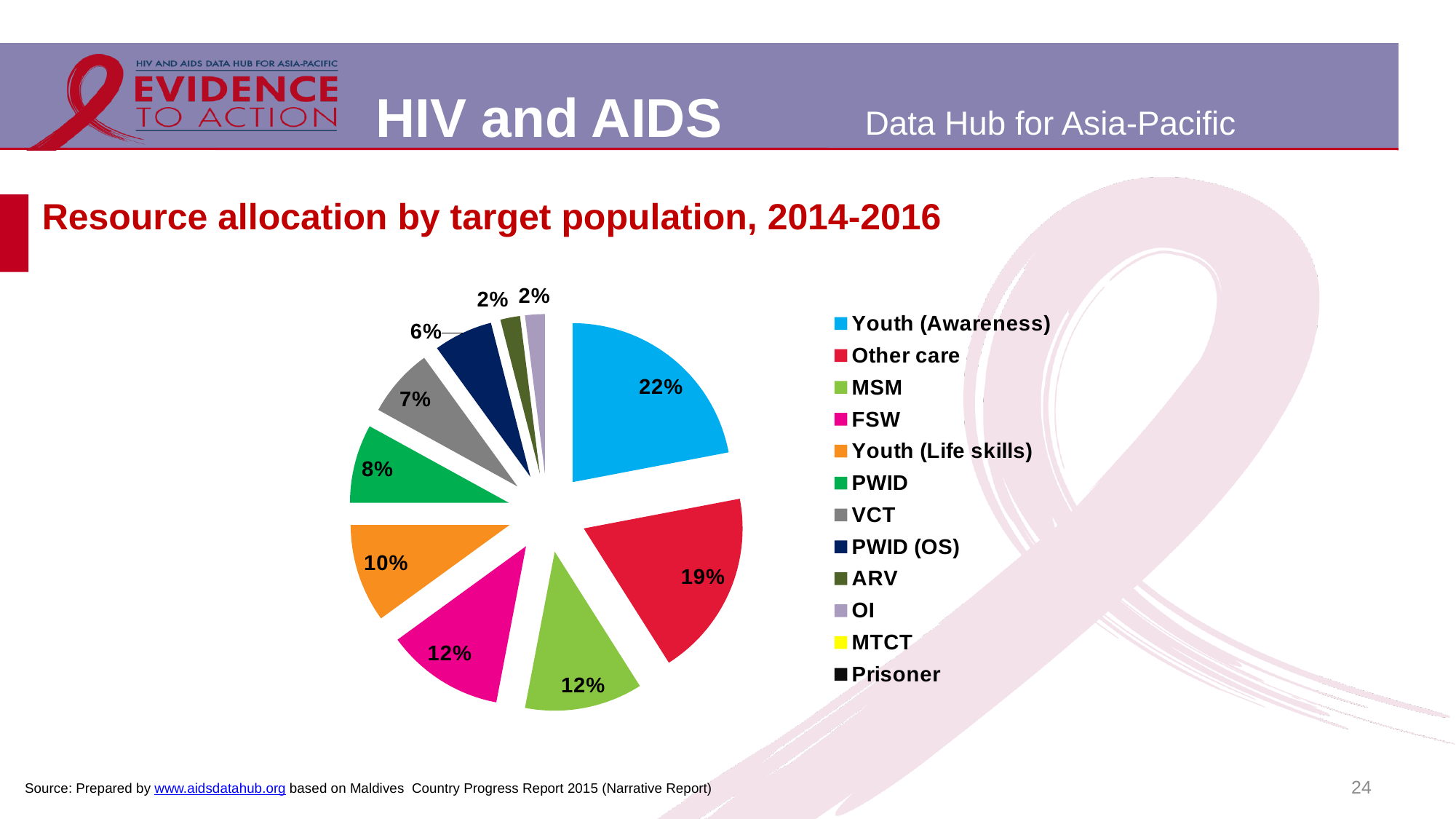
How many entries does the legend list? 12 What type of chart is shown on the slide? Pie chart What percentage is allocated to PWID (OS)? 6% What is the difference in percentage points between the Youth (Awareness) and Other care shares? 3 Which receives a larger share, FSW or PWID? FSW What is the title of the chart? Resource allocation by target population, 2014-2016 What share does VCT receive? 7% Which target population receives the largest share of resources? Youth (Awareness) What percentage of resources goes to PWID? 8% What percentage of the pie is the Other care slice? 19% What share is allocated to Youth (Life skills)? 10% What share of resources is allocated to Youth (Awareness)? 22%